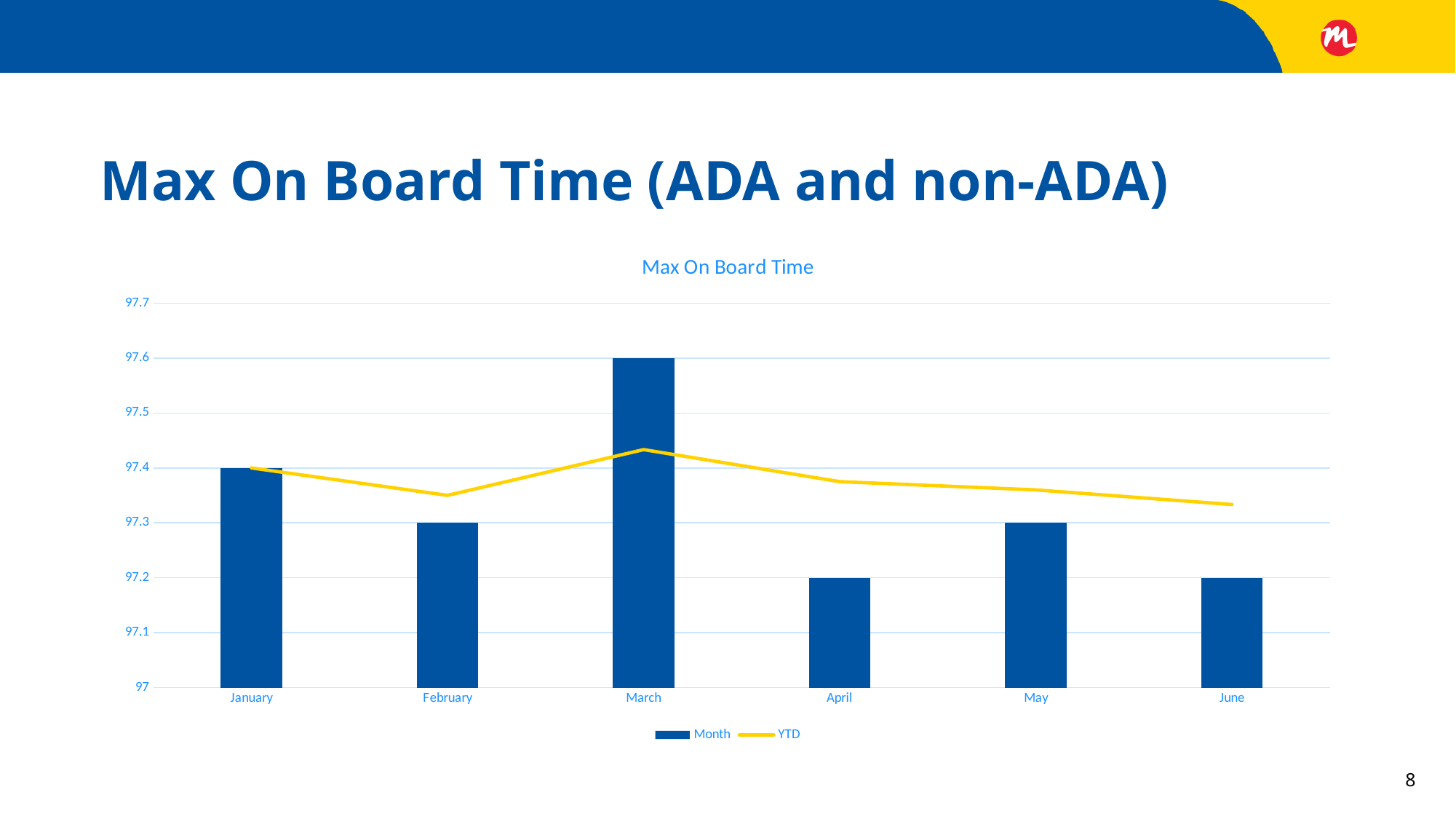
Which has the larger Month value, January or February? January How many months are shown on the x axis? 6 Does the YTD line rise or fall from March to June? fall Which month has the highest Month bar? March What is the Month value for March? 97.6 Is the YTD value for June greater or less than 97.4? less Is the YTD value for March greater or less than 97.4? greater How many series does the legend list? 2 What is the difference between the Month values for March and February? 0.3 What are the two entries in the chart legend? Month and YTD What is the Month value for April? 97.2 What is the Month value for January? 97.4